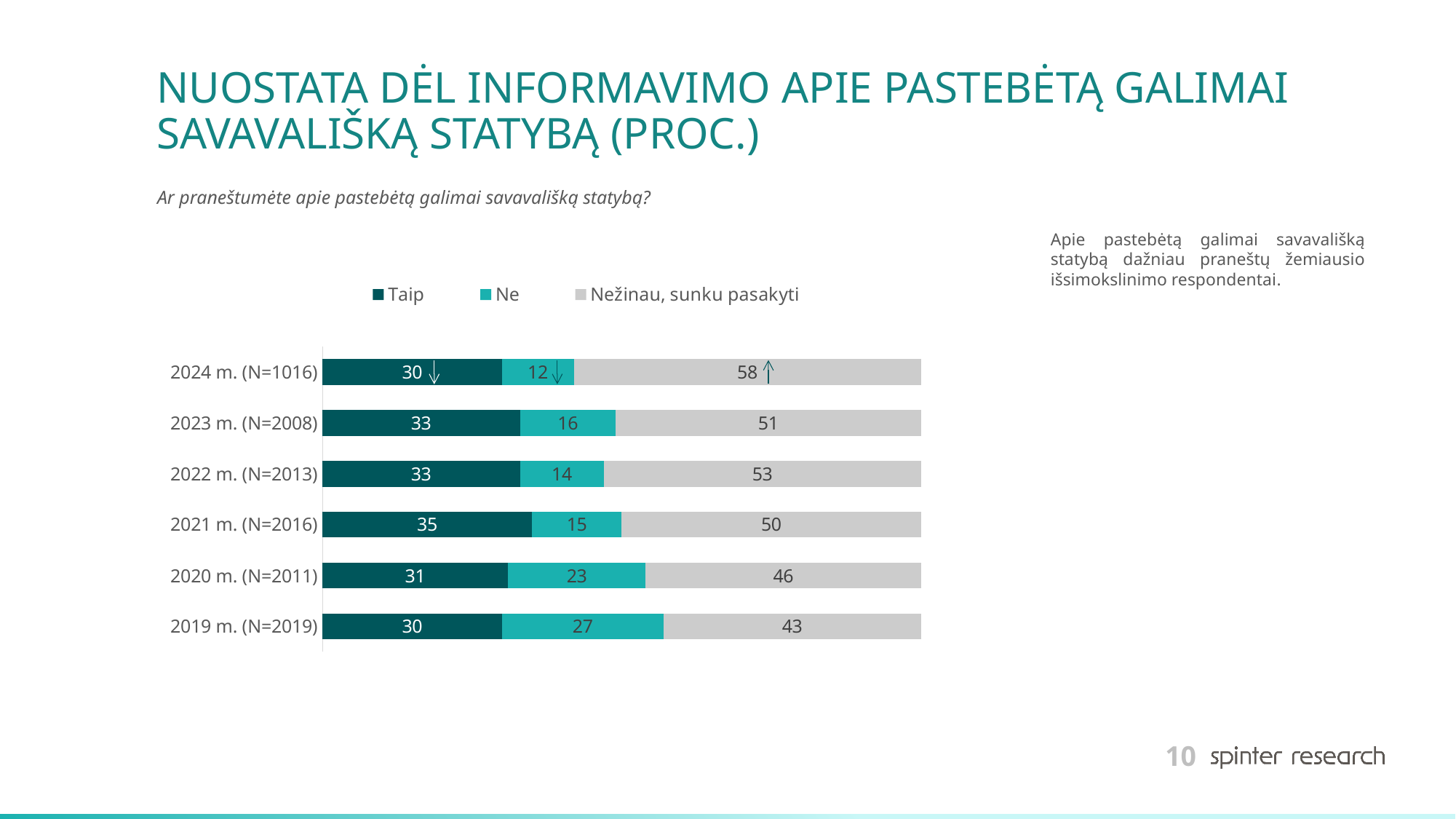
What is the value for "Ne" in 2019 m. (N=2019)? 27 How many year categories are plotted in the chart? 6 How does the "Ne" value change from 2019 m. to 2024 m.? It falls How many series does the legend list? 3 What kind of chart is shown on the slide? Stacked bar chart What is the value for "Taip" in 2024 m. (N=1016)? 30 What is the difference between the "Nežinau, sunku pasakyti" values for 2024 m. (N=1016) and 2019 m. (N=2019)? 15 Which is larger: the "Ne" value for 2020 m. (N=2011) or for 2021 m. (N=2016)? 2020 m. (N=2011) What is the total of the stacked bar for 2023 m. (N=2008)? 100 Which year has the lowest value for "Ne"? 2024 m. (N=1016) Which year has the highest value for "Taip"? 2021 m. (N=2016) What is the value for "Nežinau, sunku pasakyti" in 2022 m. (N=2013)? 53